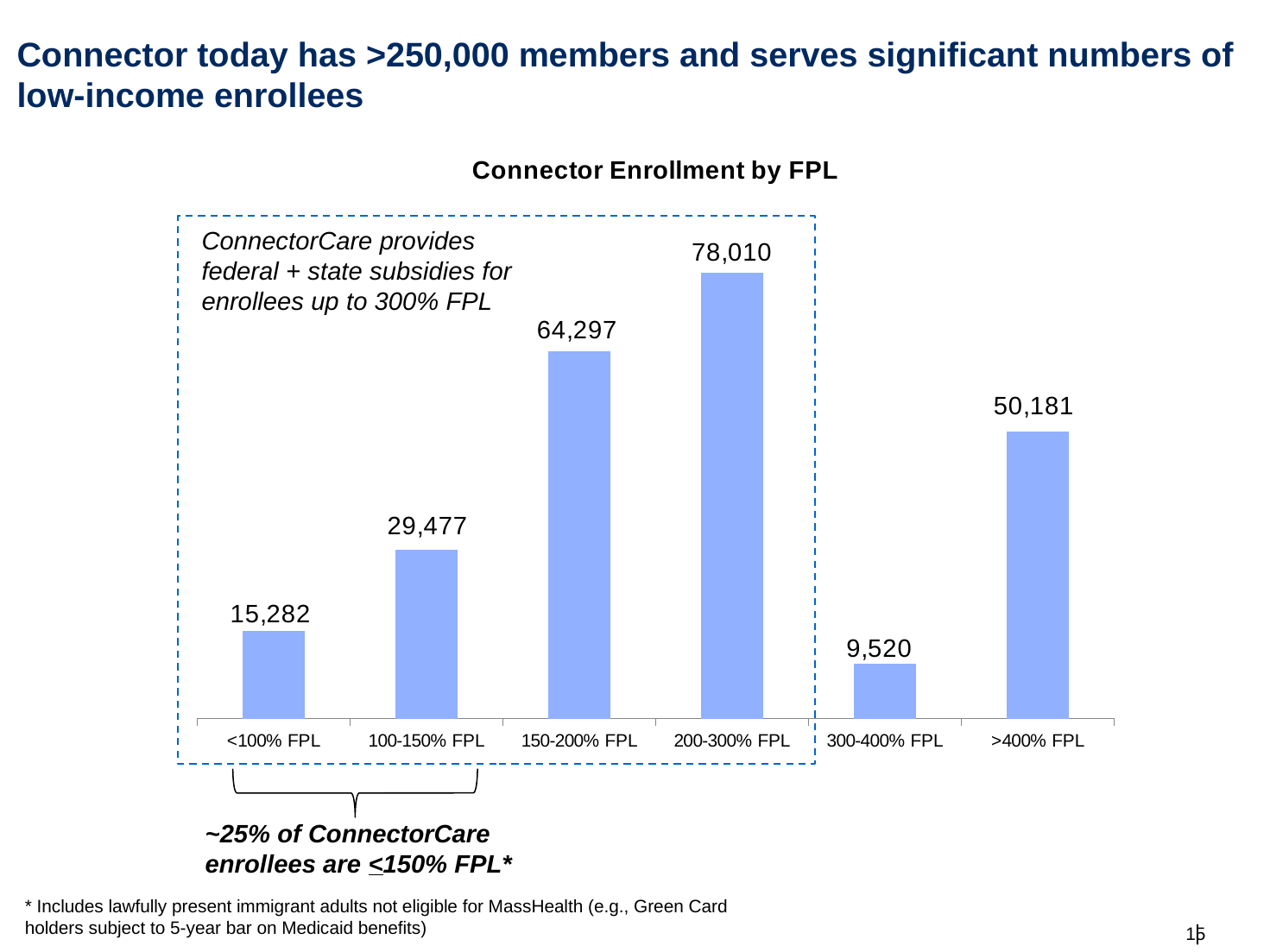
What is the enrollment value for the 200-300% FPL category? 78,010 Which FPL category has the highest enrollment? 200-300% FPL What is the difference in enrollment between the 100-150% FPL and <100% FPL categories? 14,195 What is the enrollment value for the 300-400% FPL category? 9,520 What is the enrollment value for the >400% FPL category? 50,181 What is the title of the chart? Connector Enrollment by FPL Which FPL category has the lowest enrollment? 300-400% FPL How many FPL categories are shown in the chart? 6 What is the enrollment value for the <100% FPL category? 15,282 Which has higher enrollment, the 150-200% FPL category or the >400% FPL category? 150-200% FPL What type of chart is used to show Connector Enrollment by FPL? Bar chart What is the difference in enrollment between the 200-300% FPL and 150-200% FPL categories? 13,713